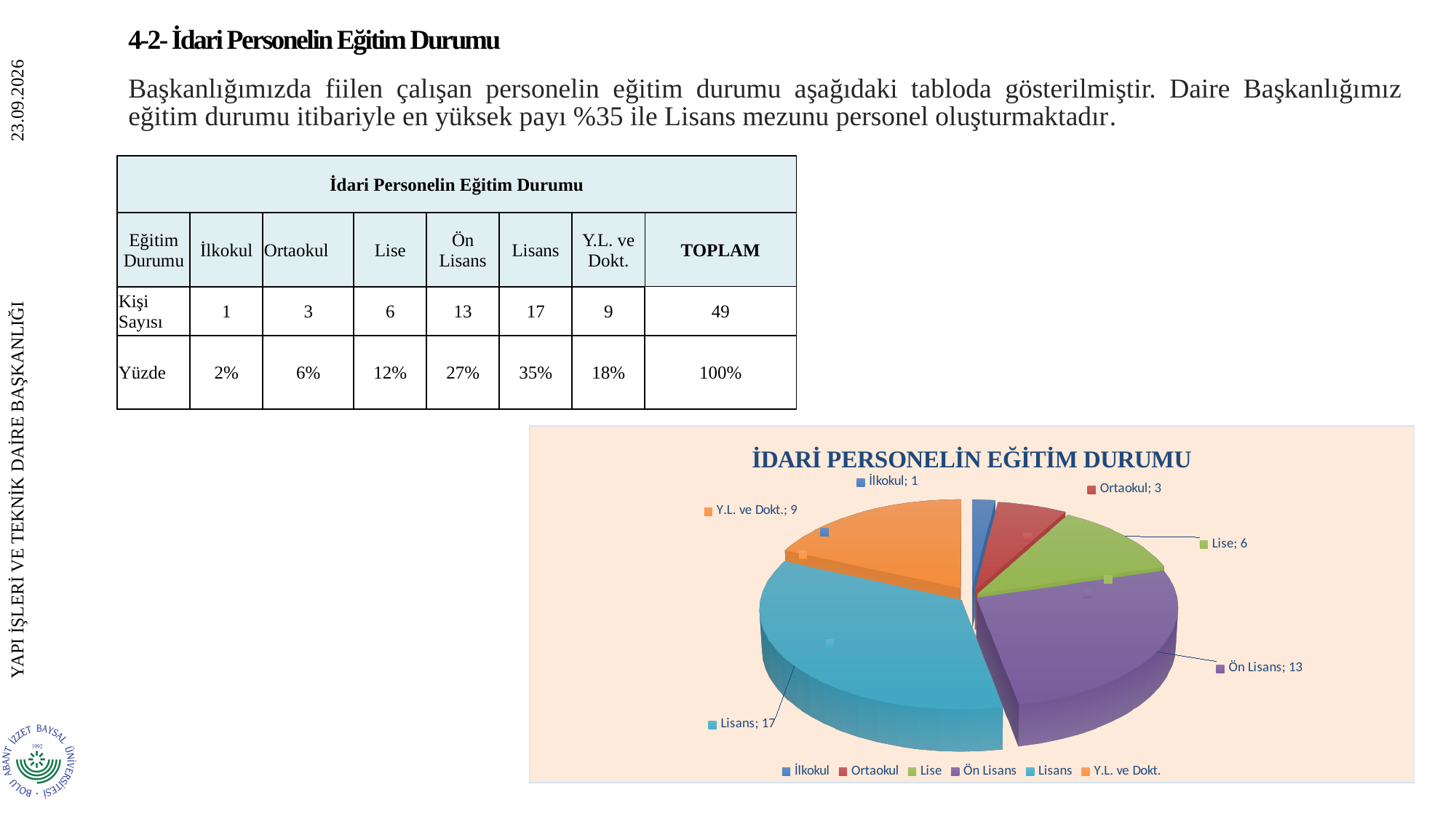
What colour is the Lisans slice in the pie chart? light blue What is the title of the pie chart? İDARİ PERSONELİN EĞİTİM DURUMU What is the value for Lise in the pie chart? 6 Which category has the smallest slice in the pie chart? İlkokul What is the value for Ön Lisans in the pie chart? 13 What is the value for Y.L. ve Dokt. in the pie chart? 9 What is the value for Lisans in the pie chart? 17 Which category has the largest slice in the pie chart? Lisans What is the difference between the values for Lisans and Ön Lisans in the pie chart? 4 What type of chart is shown on the slide? pie chart How many categories does the pie chart show? 6 Which is larger in the pie chart, Ortaokul or Lise? Lise